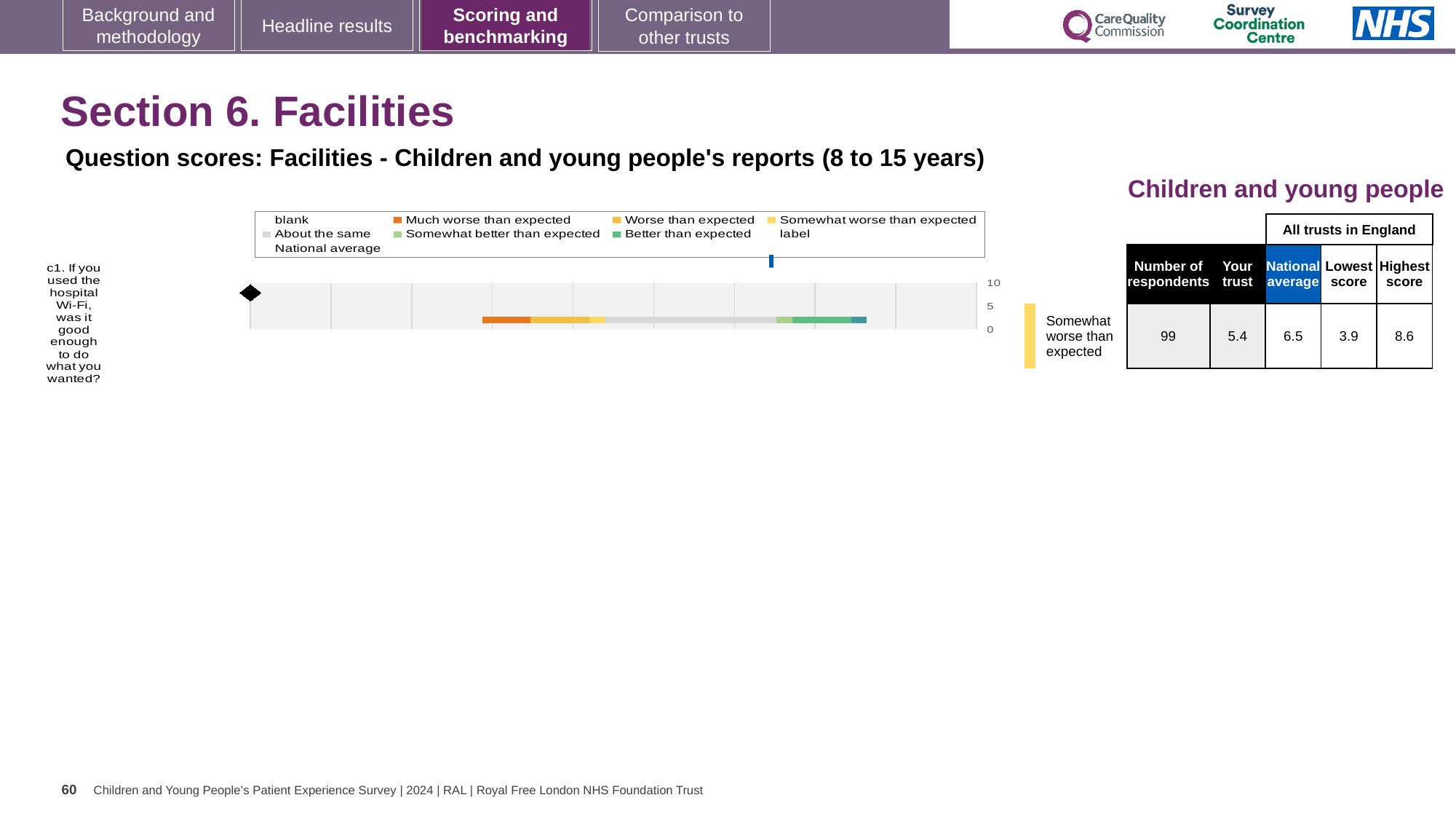
How many entries does the chart legend list? 9 In the table beside the chart, how many respondents answered question c1? 99 In the table beside the chart, what is the national average score for question c1? 6.5 What kind of chart is shown on the slide? bar chart In the table beside the chart, what is the 'Your trust' score for question c1? 5.4 What colour represents 'Much worse than expected' in the chart legend? orange In the table beside the chart, which is larger for question c1: the 'Your trust' score or the national average? National average Which benchmark band is the trust's score for question c1 placed in, according to the label beside the chart? Somewhat worse than expected In the table beside the chart, what is the difference between the national average and the 'Your trust' score for question c1? 1.1 How many questions (categories) are plotted in the chart? 1 What is the highest value shown on the chart's axis? 10 In the table beside the chart, what is the difference between the highest score and the lowest score for question c1? 4.7